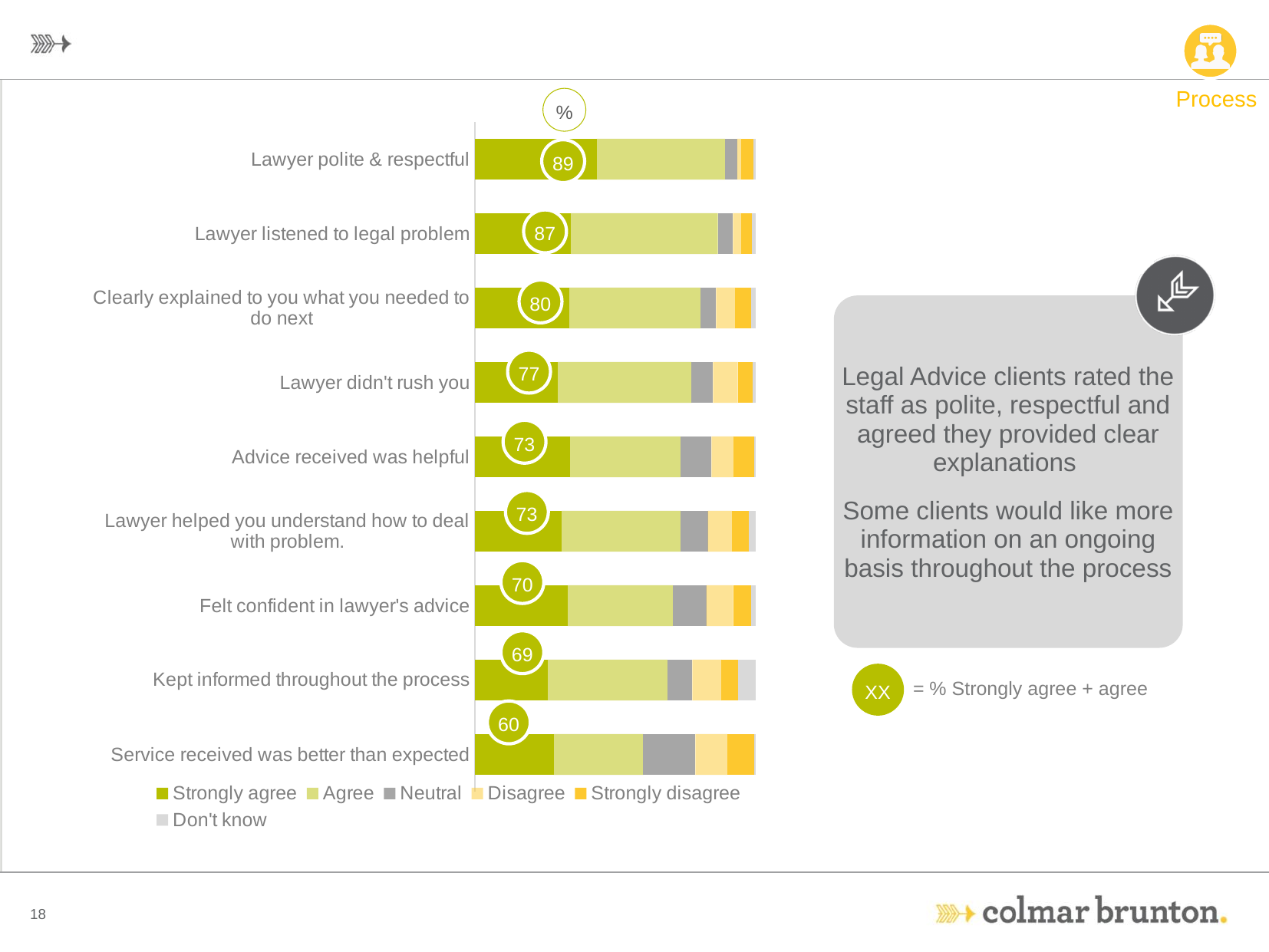
What is the difference between the combined agreement percentages for "Lawyer didn't rush you" and "Felt confident in lawyer's advice"? 7 What is the combined strongly agree + agree percentage for "Kept informed throughout the process"? 69 According to the key on the slide, what do the numbers in the circles represent? % Strongly agree + agree How many series does the legend list? 6 Which has a higher combined agreement percentage: "Lawyer listened to legal problem" or "Advice received was helpful"? Lawyer listened to legal problem What is the combined percentage of strongly agree and agree for "Lawyer polite & respectful"? 89 Which statement has the lowest combined strongly agree + agree percentage? Service received was better than expected What is the difference between the combined agreement percentages for "Lawyer polite & respectful" and "Service received was better than expected"? 29 Which statement has the highest combined strongly agree + agree percentage? Lawyer polite & respectful What is the combined strongly agree + agree percentage for "Clearly explained to you what you needed to do next"? 80 What kind of chart is shown on the slide? Stacked bar chart How many statements are shown in the chart? 9